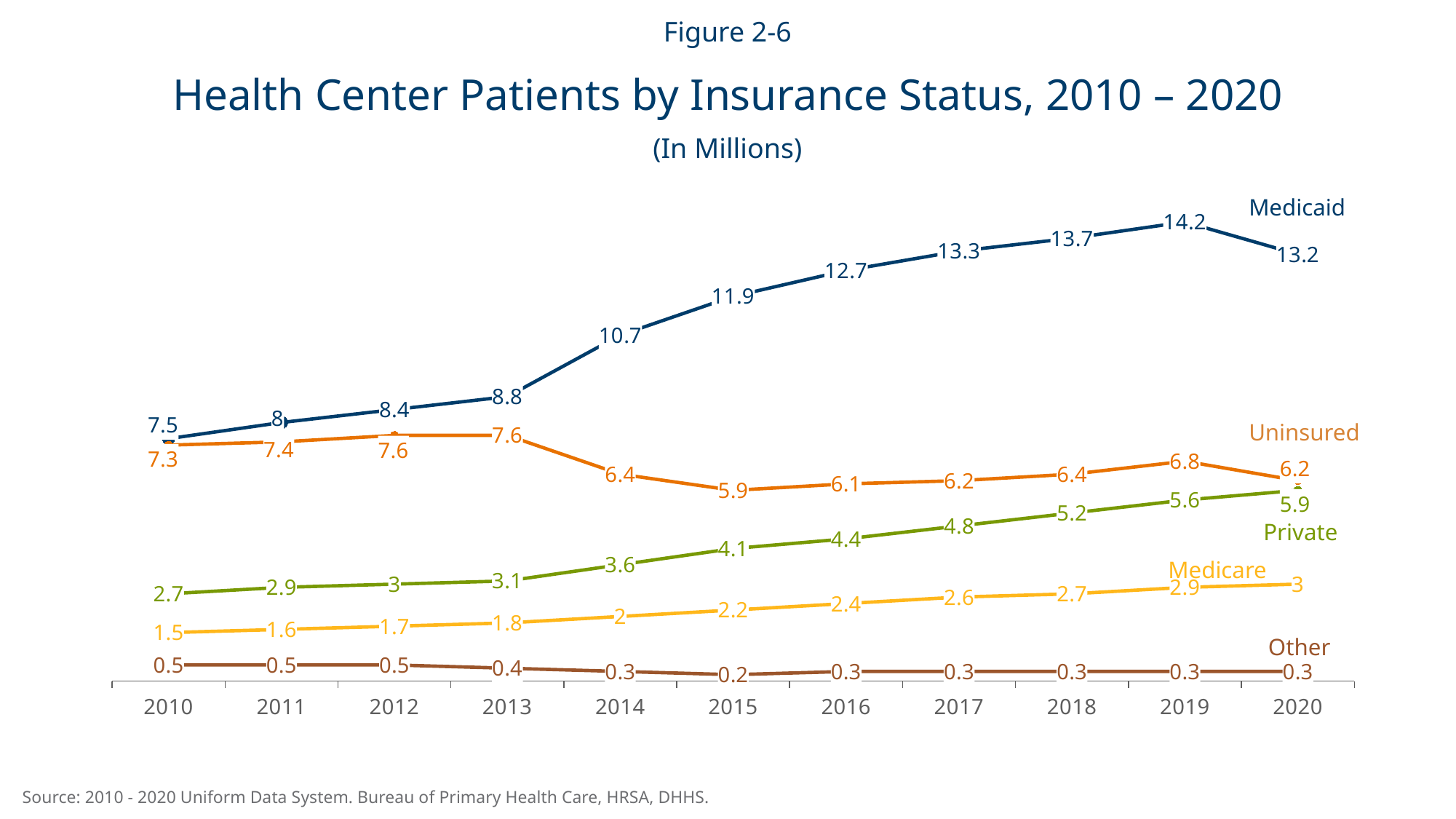
In which year did Medicaid patients reach their highest value? 2019 In which year did the Other category reach its lowest value? 2015 What type of chart is shown on the slide? Line chart How many insurance status series are plotted on the chart? 5 What was the number of Medicare health center patients (in millions) in 2010? 1.5 What was the number of Medicaid health center patients (in millions) in 2019? 14.2 What was the number of Private insurance health center patients (in millions) in 2020? 5.9 What is the difference between Medicaid patients in 2020 and in 2010 (in millions)? 5.7 What was the number of Uninsured health center patients (in millions) in 2015? 5.9 Which was larger in 2010, Medicaid patients or Uninsured patients? Medicaid How many years are shown on the x axis? 11 Did Private insurance patients rise or fall from 2010 to 2020? Rise